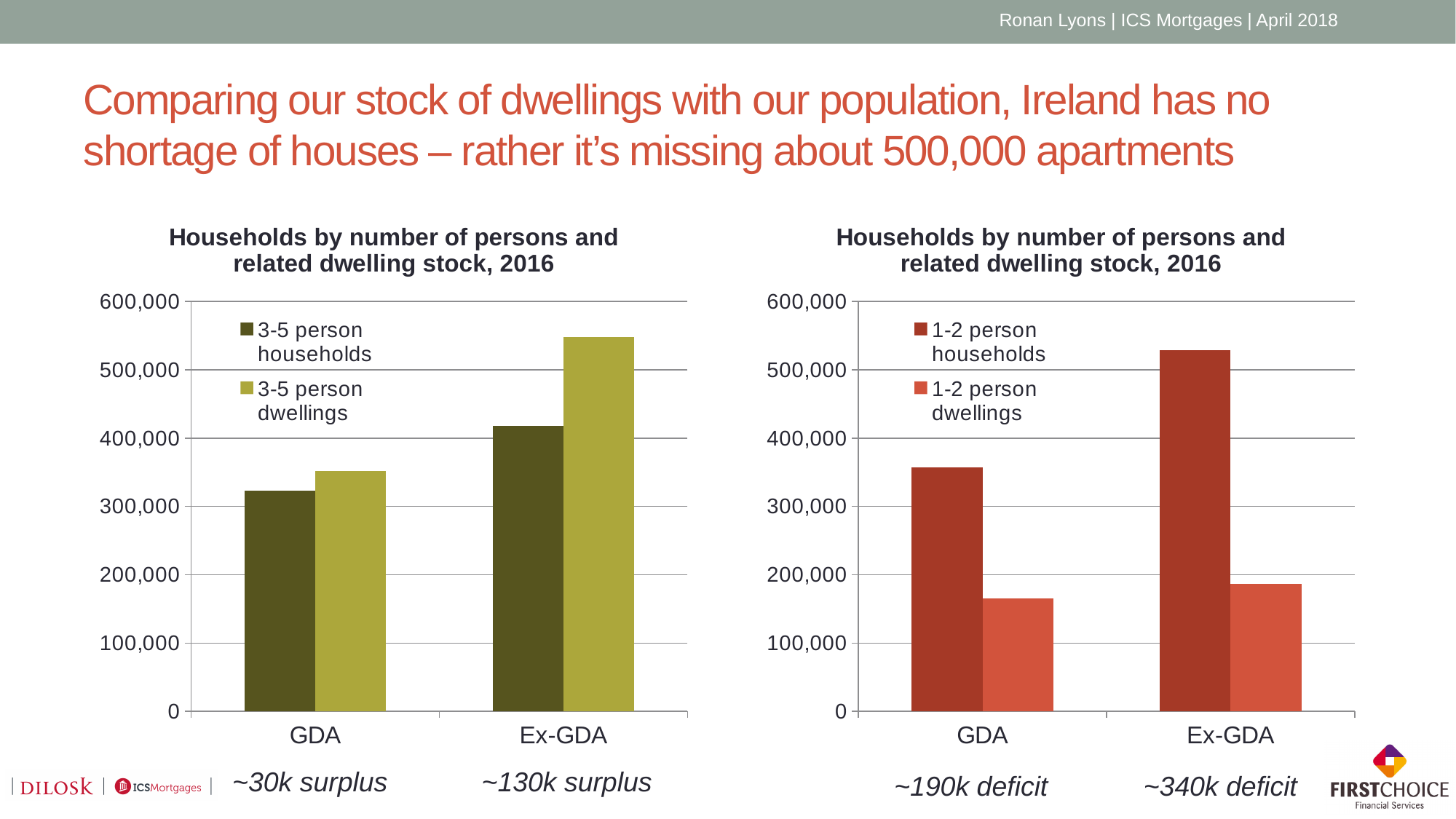
How many categories are shown on the x axis of the left chart? 2 How many series does the legend of the right chart list? 2 What kind of chart is the left chart on the slide? bar chart In the left chart, which category has the highest value for 3-5 person dwellings? Ex-GDA In the right chart, is the value for 1-2 person households in Ex-GDA greater or less than 500,000? greater In the left chart, is the value for 3-5 person dwellings in Ex-GDA greater or less than 500,000? greater What is the title of the right chart? Households by number of persons and related dwelling stock, 2016 In the right chart, which category has the lowest value for 1-2 person dwellings? GDA In the left chart, is the value for 3-5 person households in GDA greater or less than 400,000? less In the left chart, which is larger for GDA: 3-5 person households or 3-5 person dwellings? 3-5 person dwellings In the right chart, which is larger for Ex-GDA: 1-2 person households or 1-2 person dwellings? 1-2 person households